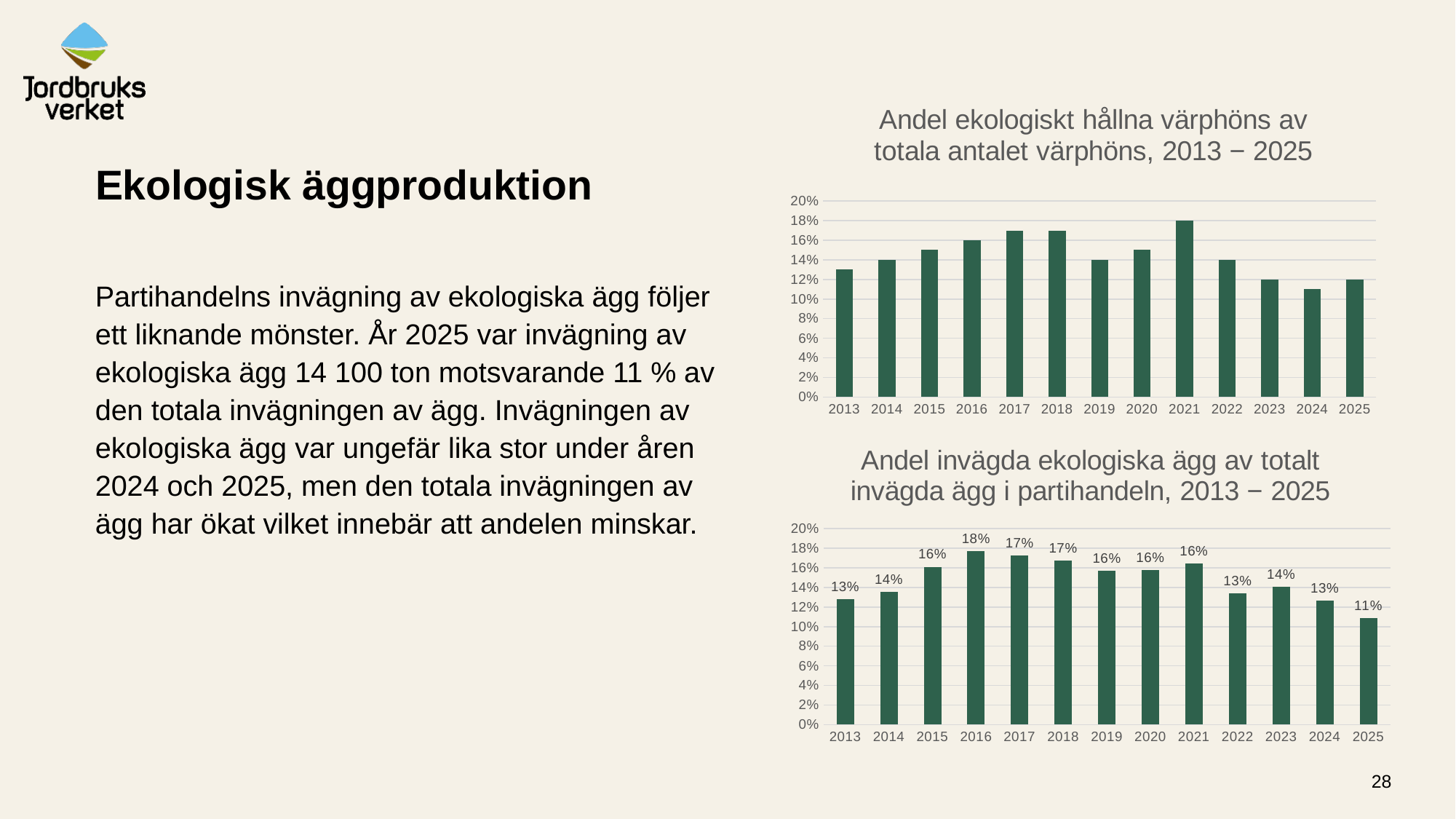
In the bottom chart (Andel invägda ekologiska ägg av totalt invägda ägg i partihandeln), which year has the lowest value? 2025 In the bottom chart (Andel invägda ekologiska ägg av totalt invägda ägg i partihandeln), which is larger, the value for 2015 or the value for 2022? 2015 In the top chart (Andel ekologiskt hållna värphöns av totala antalet värphöns), how many years are shown on the x axis? 13 In the bottom chart (Andel invägda ekologiska ägg av totalt invägda ägg i partihandeln), what is the difference between the values for 2016 and 2025? 7 percentage points In the bottom chart (Andel invägda ekologiska ägg av totalt invägda ägg i partihandeln), what is the value for 2016? 18% In the bottom chart (Andel invägda ekologiska ägg av totalt invägda ägg i partihandeln), what is the value for 2013? 13% In the top chart (Andel ekologiskt hållna värphöns av totala antalet värphöns), which year has the highest value? 2021 In the bottom chart (Andel invägda ekologiska ägg av totalt invägda ägg i partihandeln), what is the value for 2025? 11% What kind of chart is the bottom chart (Andel invägda ekologiska ägg av totalt invägda ägg i partihandeln)? Bar chart In the bottom chart (Andel invägda ekologiska ägg av totalt invägda ägg i partihandeln), which year has the highest value? 2016 In the top chart (Andel ekologiskt hållna värphöns av totala antalet värphöns), which year has the lowest value? 2024 In the top chart (Andel ekologiskt hållna värphöns av totala antalet värphöns), is the value for 2021 greater or less than 16%? greater